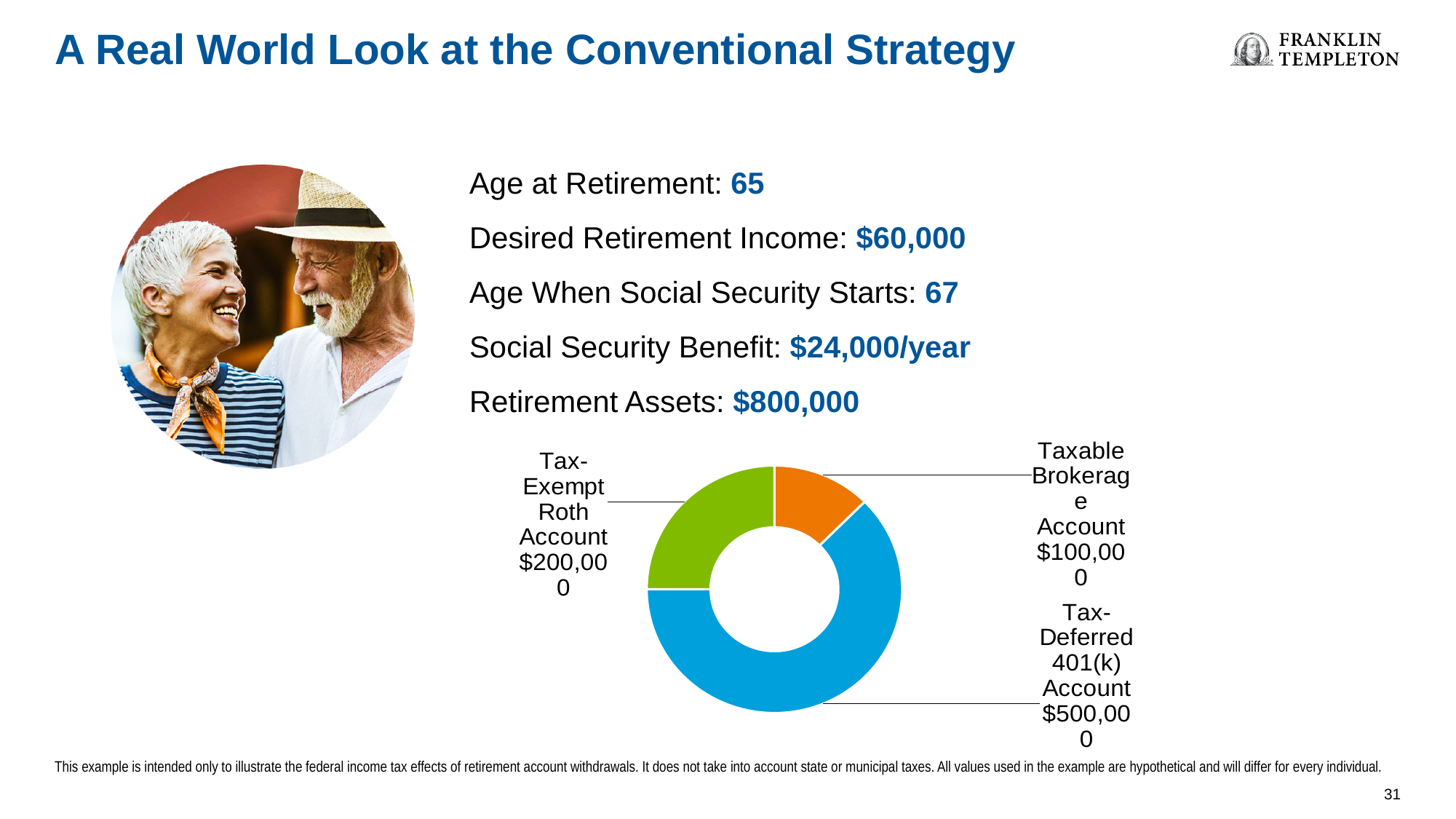
How many slices does the donut chart have? 3 Which account holds the largest share of the retirement assets? Tax-Deferred 401(k) Account Which is larger, the Tax-Exempt Roth Account or the Taxable Brokerage Account? Tax-Exempt Roth Account What is the total of all three slices in the donut chart? $800,000 What is the value of the Tax-Exempt Roth Account slice? $200,000 What colour is the Tax-Exempt Roth Account slice? Green What is the difference between the Tax-Deferred 401(k) Account and the Tax-Exempt Roth Account values? $300,000 What is the value of the Tax-Deferred 401(k) Account slice? $500,000 What kind of chart is shown on the slide? Donut (pie) chart What share of the total retirement assets does the Tax-Deferred 401(k) Account represent? 62.5% What is the value of the Taxable Brokerage Account slice? $100,000 Which account holds the smallest share of the retirement assets? Taxable Brokerage Account